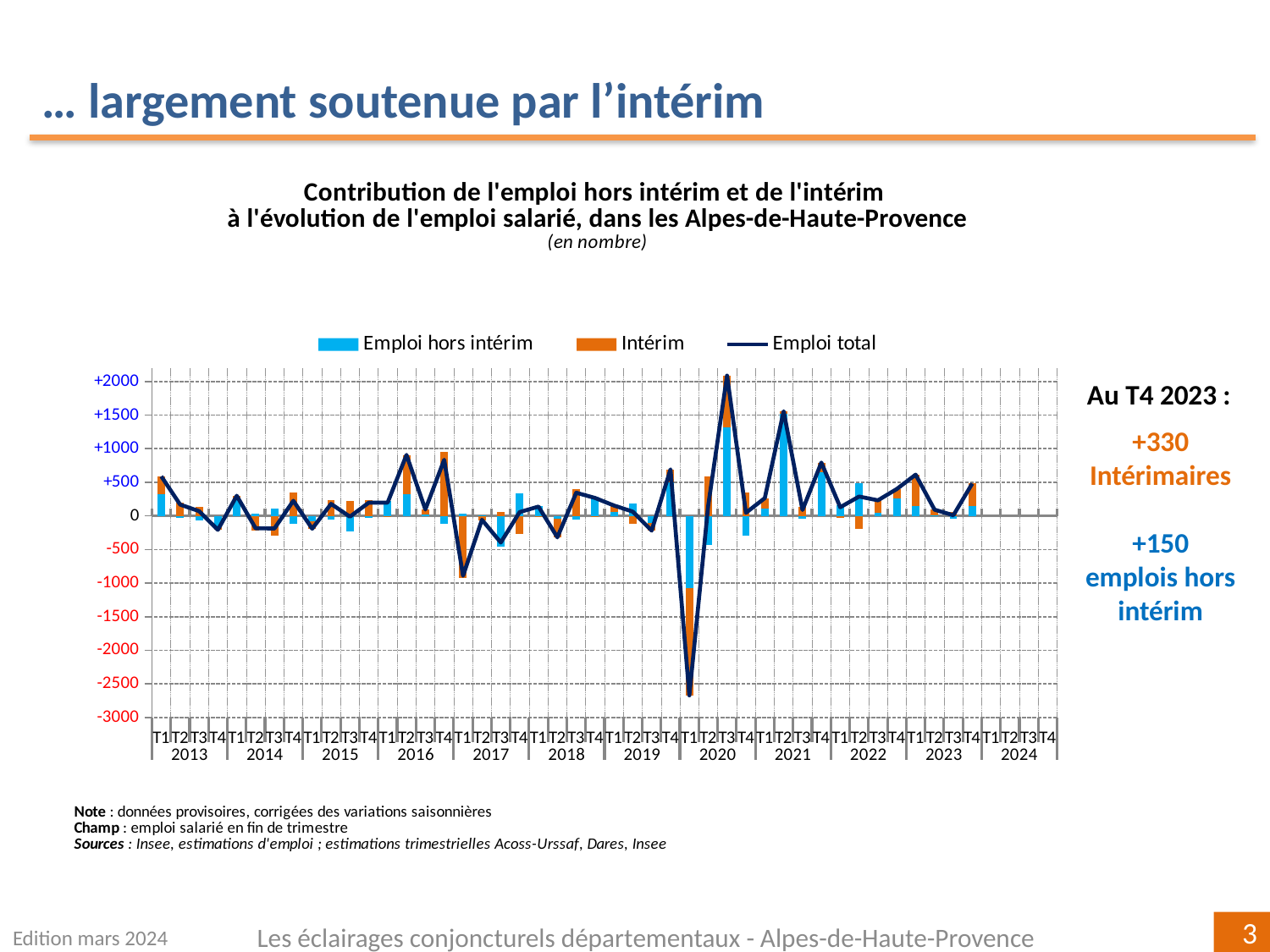
What is the total of the intérim (+330) and hors intérim (+150) contributions at T4 2023? +480 In which quarter does the Emploi total line reach its highest point? T3 2020 At T4 2023, which is larger: the intérim contribution or the hors intérim contribution? Intérim Which colour represents the Intérim series in the chart? Orange What kind of chart is shown on the slide? A bar chart combined with a line chart According to the annotation, what is the value for emplois hors intérim at T4 2023? +150 Is the value of Emploi total at T1 2021 greater or less than 1000? less According to the annotation, what is the value for Intérimaires at T4 2023? +330 In which quarter does the Emploi total line reach its lowest point? T1 2020 Is the value of Emploi total at T1 2020 greater or less than -2000? less What is the difference between the intérim (+330) and hors intérim (+150) contributions at T4 2023? 180 How many series does the legend list? 3